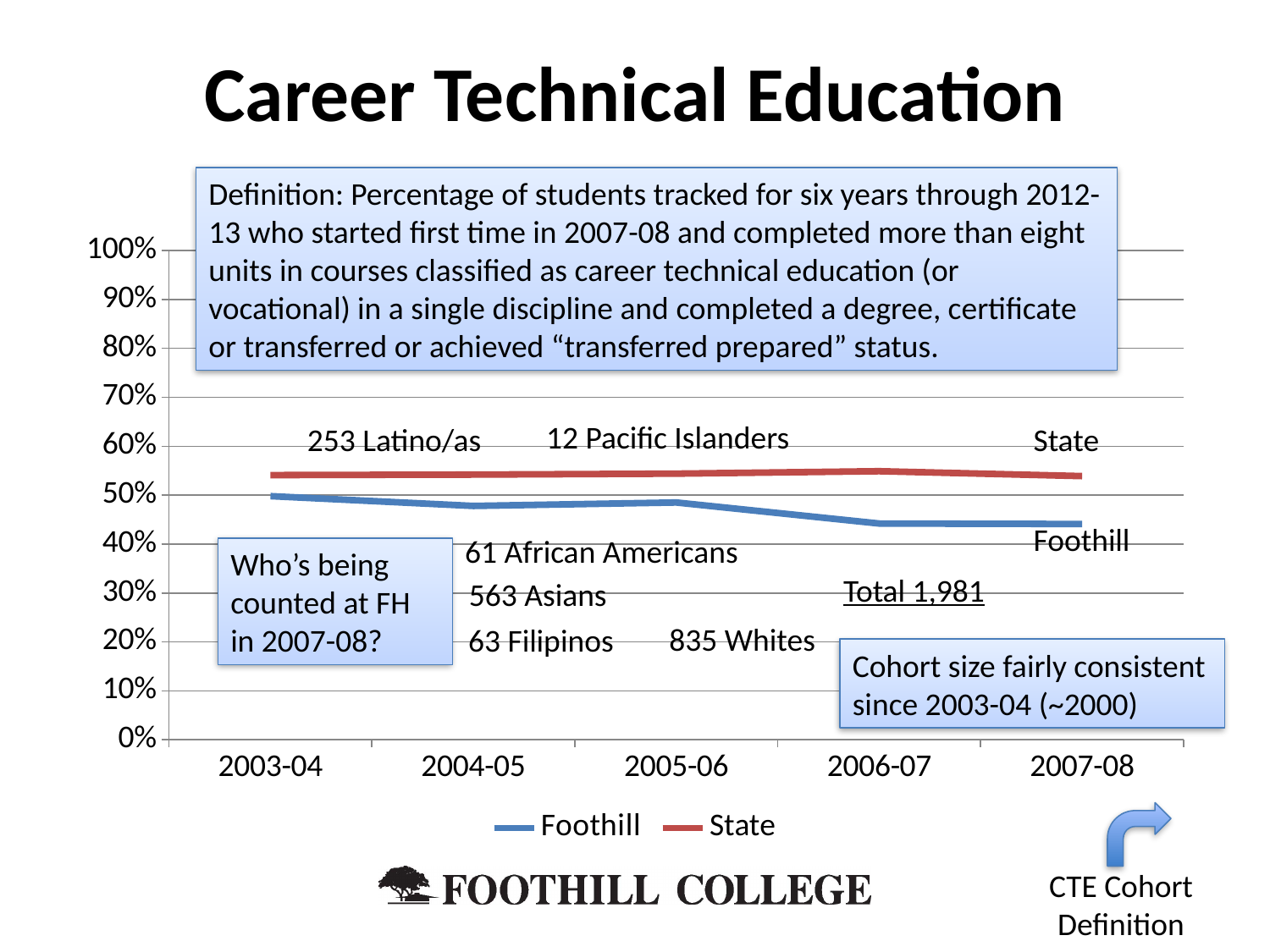
How many series does the chart legend list? 2 Is the State value for 2007-08 greater or less than 60%? less Is the State value for 2003-04 greater or less than 50%? greater Does the Foothill series rise or fall overall from 2003-04 to 2007-08? fall In which year is the Foothill series at its highest? 2003-04 Which series is plotted with the red line? State In 2007-08, which series has the higher value, Foothill or State? State What kind of chart is shown on the slide? line chart Is the Foothill value for 2006-07 greater or less than 50%? less How many academic years are plotted along the x axis? 5 What is the title of the slide containing the chart? Career Technical Education